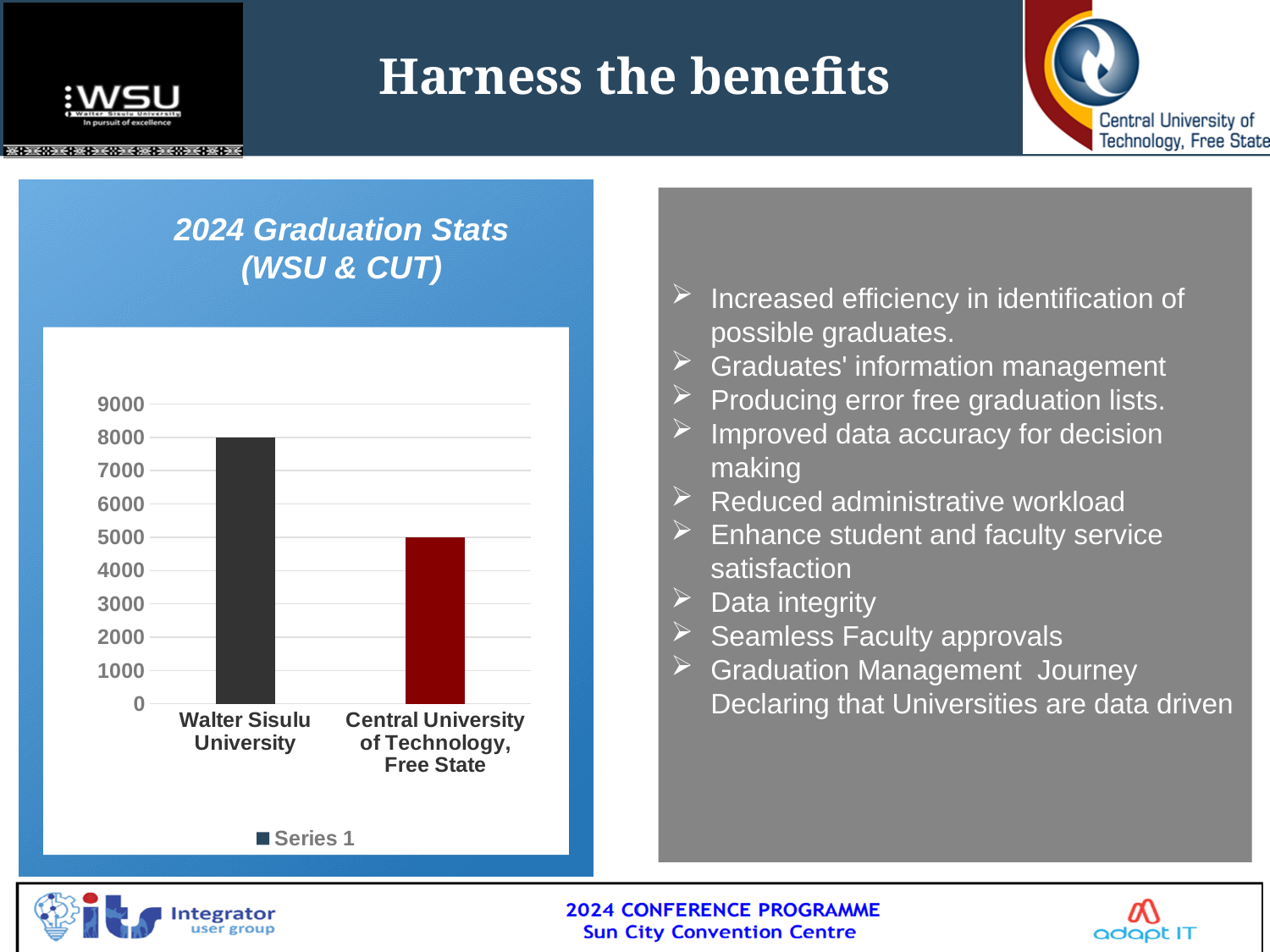
Which university has the lowest value in the chart? Central University of Technology, Free State What is the value for Central University of Technology, Free State? 5000 What is the difference between the values for Walter Sisulu University and Central University of Technology, Free State? 3000 How many categories are plotted in the chart? 2 What type of chart is shown on the slide? bar chart Which university has the highest value in the chart? Walter Sisulu University What is the value for Walter Sisulu University? 8000 How many series does the chart legend list? 1 What is the title of the chart? 2024 Graduation Stats (WSU & CUT) Which is larger: the value for Walter Sisulu University or the value for Central University of Technology, Free State? Walter Sisulu University Is the value for Central University of Technology, Free State greater or less than 6000? less What is the name of the series shown in the legend? Series 1